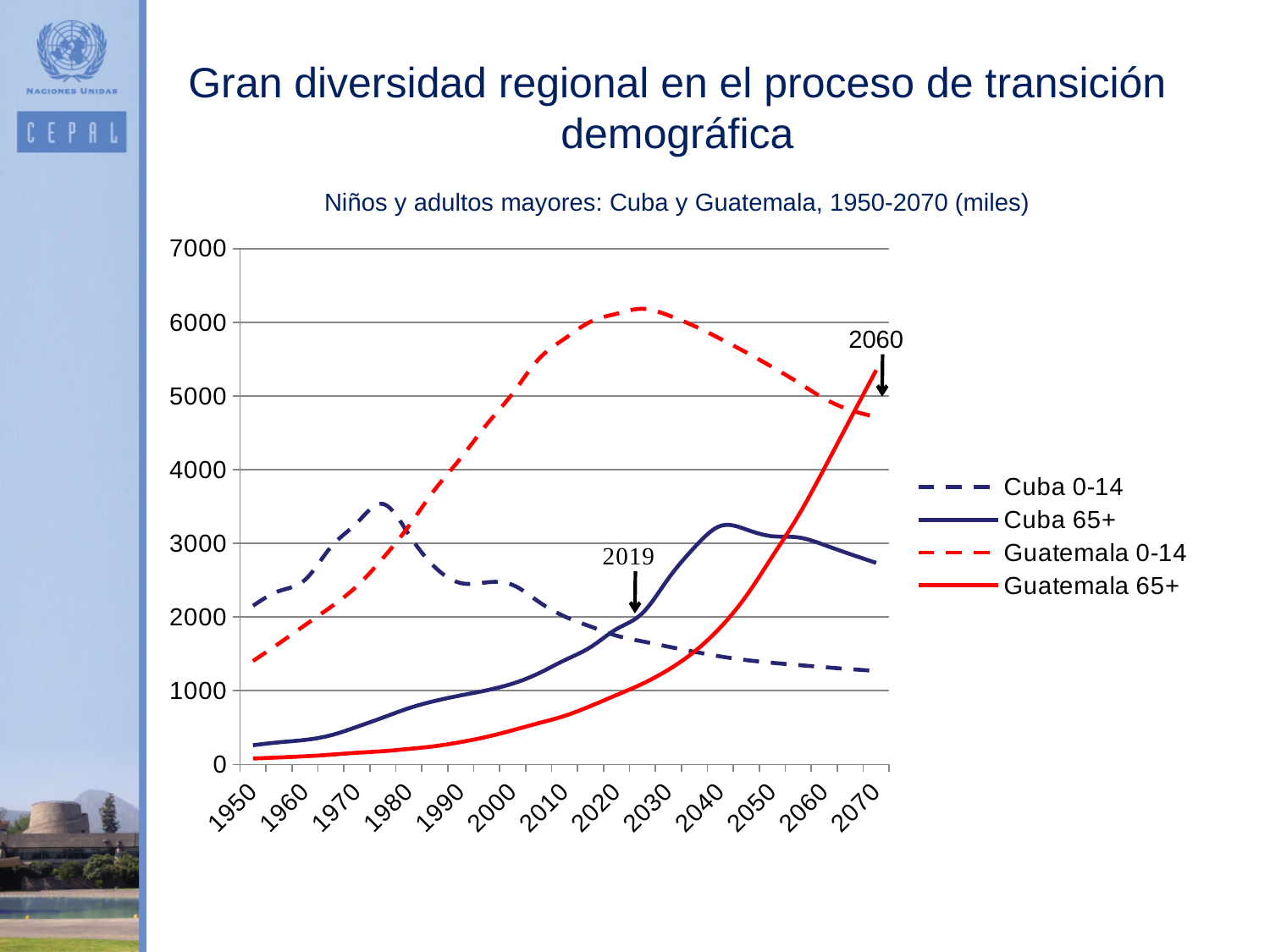
Is the value for Guatemala 65+ in 2070 greater or less than 5000? greater Is the value for Guatemala 0-14 in 2010 greater or less than 5000? greater Is the value for Cuba 0-14 in 2070 greater or less than 2000? less How many year labels are shown along the x axis? 13 What kind of chart is shown on the slide? line chart Which two years are marked with arrows on the chart? 2019 and 2060 Which series reaches the highest value anywhere on the chart? Guatemala 0-14 Which series has the lowest value in 1950? Guatemala 65+ In 2070, which is larger: Guatemala 65+ or Cuba 65+? Guatemala 65+ How many series does the legend list? 4 Does the Guatemala 65+ line rise or fall from 1950 to 2070? rise